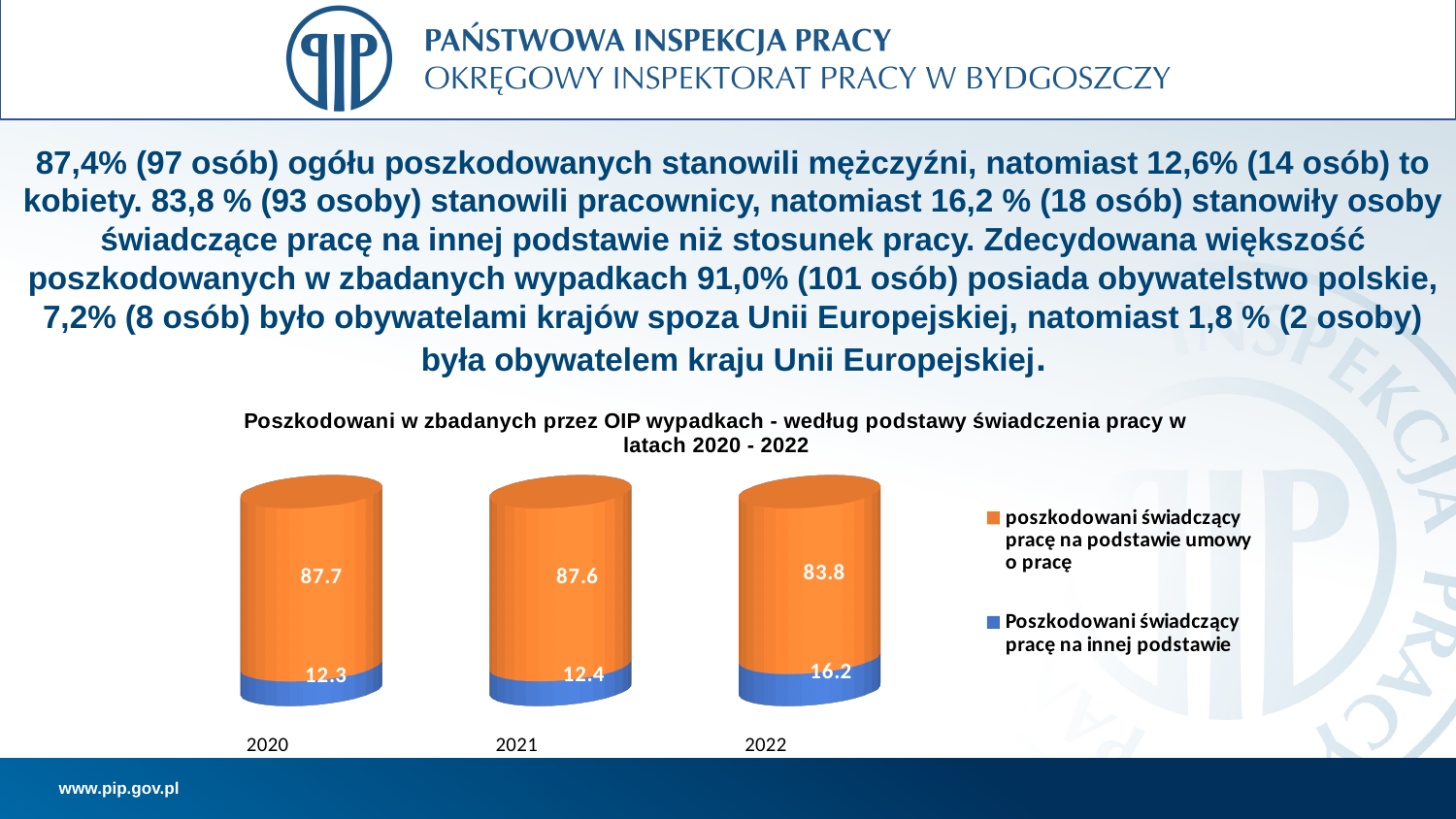
What is the difference between the "poszkodowani świadczący pracę na podstawie umowy o pracę" values for 2020 and 2022? 3.9 What is the value for "Poszkodowani świadczący pracę na innej podstawie" in 2021? 12.4 What kind of chart is shown on the slide? Stacked bar chart What is the total of the stacked bar for 2021? 100 What is the value for "Poszkodowani świadczący pracę na innej podstawie" in 2020? 12.3 Which colour represents "Poszkodowani świadczący pracę na innej podstawie" in the chart? Blue What is the value for "poszkodowani świadczący pracę na podstawie umowy o pracę" in 2022? 83.8 Which is larger: the "Poszkodowani świadczący pracę na innej podstawie" value for 2022 or for 2020? 2022 In which year is the value for "poszkodowani świadczący pracę na podstawie umowy o pracę" lowest? 2022 How many series does the chart legend list? 2 How many years are shown on the x axis of the chart? 3 In which year is the value for "Poszkodowani świadczący pracę na innej podstawie" highest? 2022